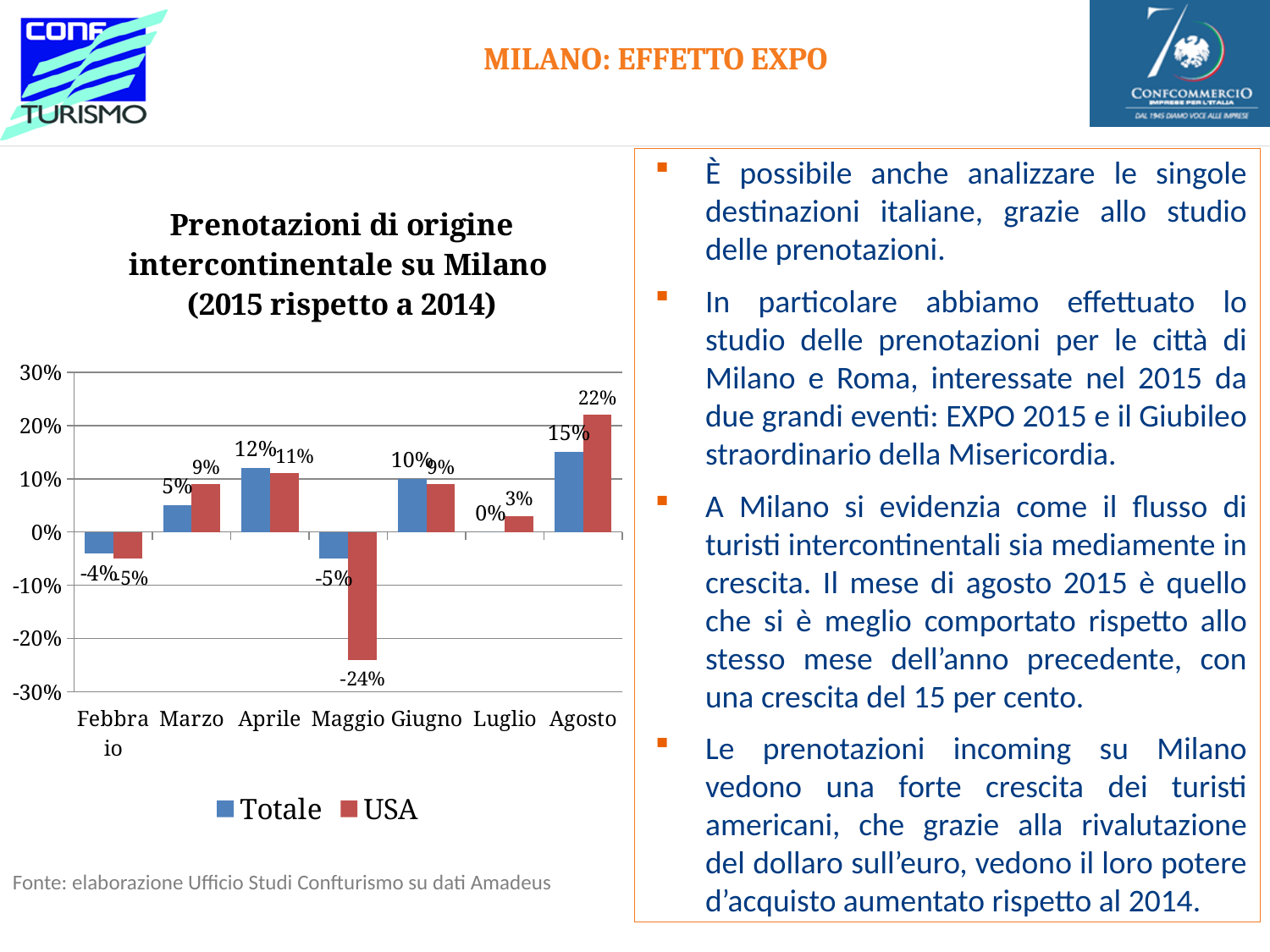
What is the difference between the USA and Totale values for Agosto? 7 percentage points Which month has the highest USA value? Agosto Which series is shown in red in the legend? USA What is the USA value for Maggio? -24% What kind of chart is shown on the slide? Bar chart How many months are shown on the x axis? 7 How many series does the legend list? 2 What is the Totale value for Aprile? 12% Which is larger for Marzo, the Totale value or the USA value? USA Which month has the lowest Totale value? Maggio What is the Totale value for Agosto? 15% What is the USA value for Luglio? 3%